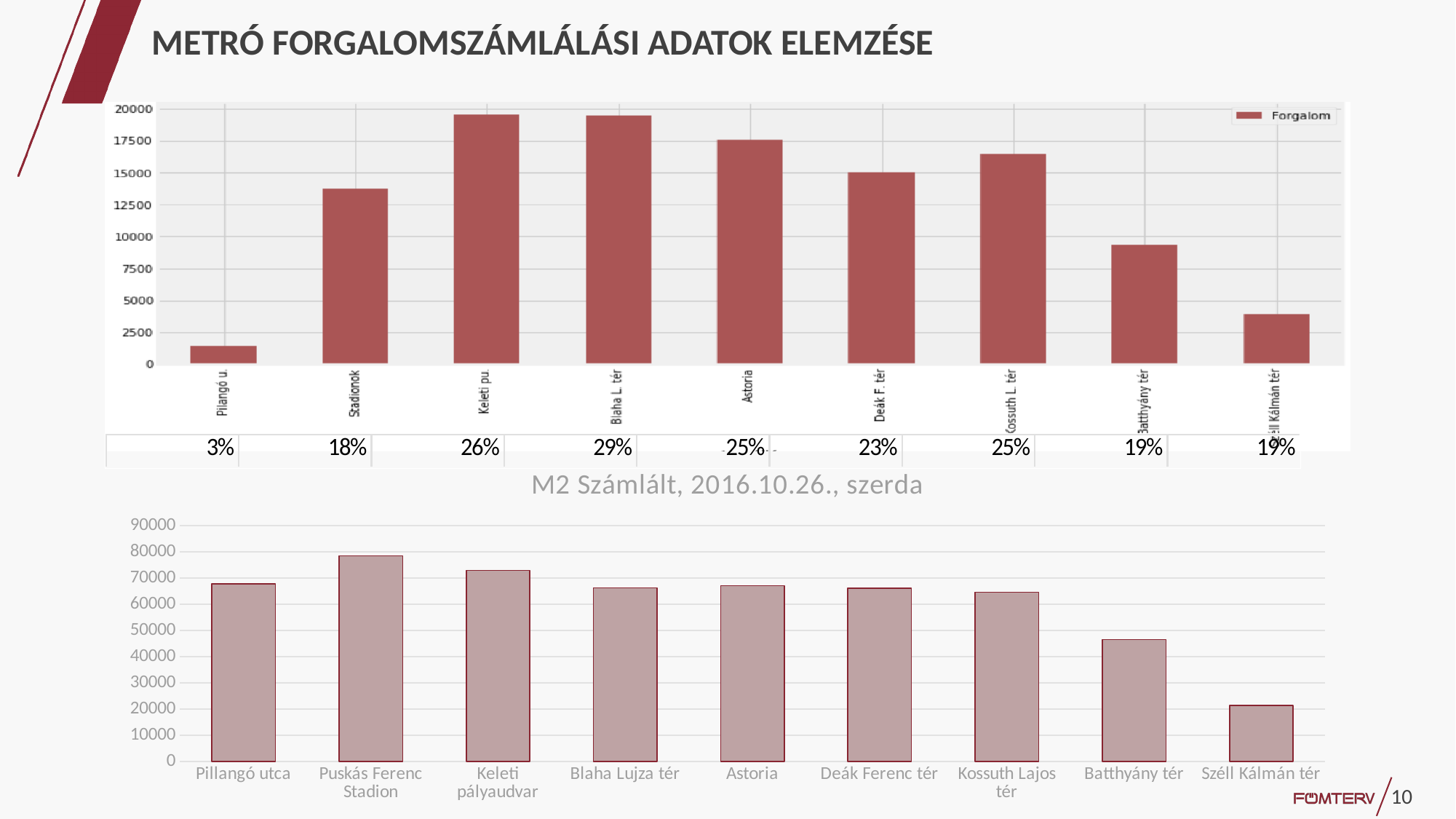
In the top chart, what series name does the legend show? Forgalom In the bottom chart (M2 Számlált), which is larger, the value for Keleti pályaudvar or for Kossuth Lajos tér? Keleti pályaudvar What is the title of the bottom chart? M2 Számlált, 2016.10.26., szerda In the top chart, which station has the lowest value? Pillangó u. How many stations are shown in the top chart? 9 In the top chart, is the value for Batthyány tér greater or less than 10000? less In the bottom chart (M2 Számlált), is the value for Batthyány tér greater or less than 50000? less In the bottom chart (M2 Számlált), which station has the lowest value? Széll Kálmán tér In the top chart, which is larger, the value for Astoria or for Deák F. tér? Astoria What kind of chart is the top chart? bar chart In the top chart, is the value for Stadionok greater or less than 12500? greater In the bottom chart (M2 Számlált), which station has the highest value? Puskás Ferenc Stadion